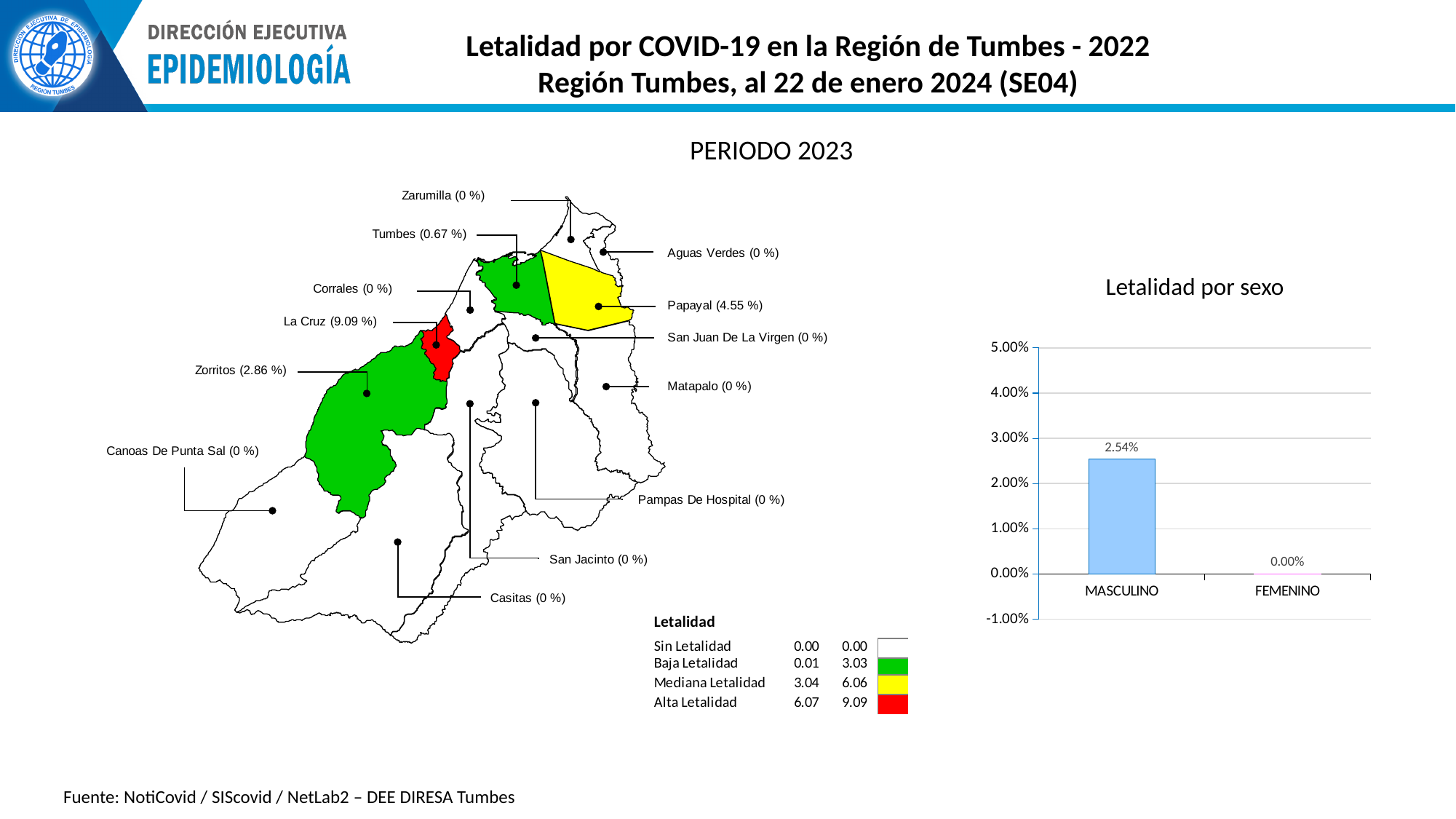
On the map 'PERIODO 2023', what is the lethality value shown for Papayal? 4.55 % In the 'Letalidad por sexo' chart, what is the highest value shown on the vertical axis? 5.00% On the map 'PERIODO 2023', what is the lethality value shown for La Cruz? 9.09 % How many categories are shown in the 'Letalidad por sexo' chart? 2 On the map 'PERIODO 2023', which district has the highest lethality value? La Cruz In the 'Letalidad por sexo' chart, is the value for MASCULINO greater or less than 3.00%? less In the 'Letalidad por sexo' chart, what is the difference between the MASCULINO and FEMENINO values? 2.54% What kind of chart is 'Letalidad por sexo'? bar chart In the 'Letalidad por sexo' chart, which category has the lowest value? FEMENINO In the 'Letalidad por sexo' chart, what is the value for FEMENINO? 0.00% In the 'Letalidad por sexo' chart, what is the value for MASCULINO? 2.54% In the 'Letalidad por sexo' chart, which category has the highest value? MASCULINO